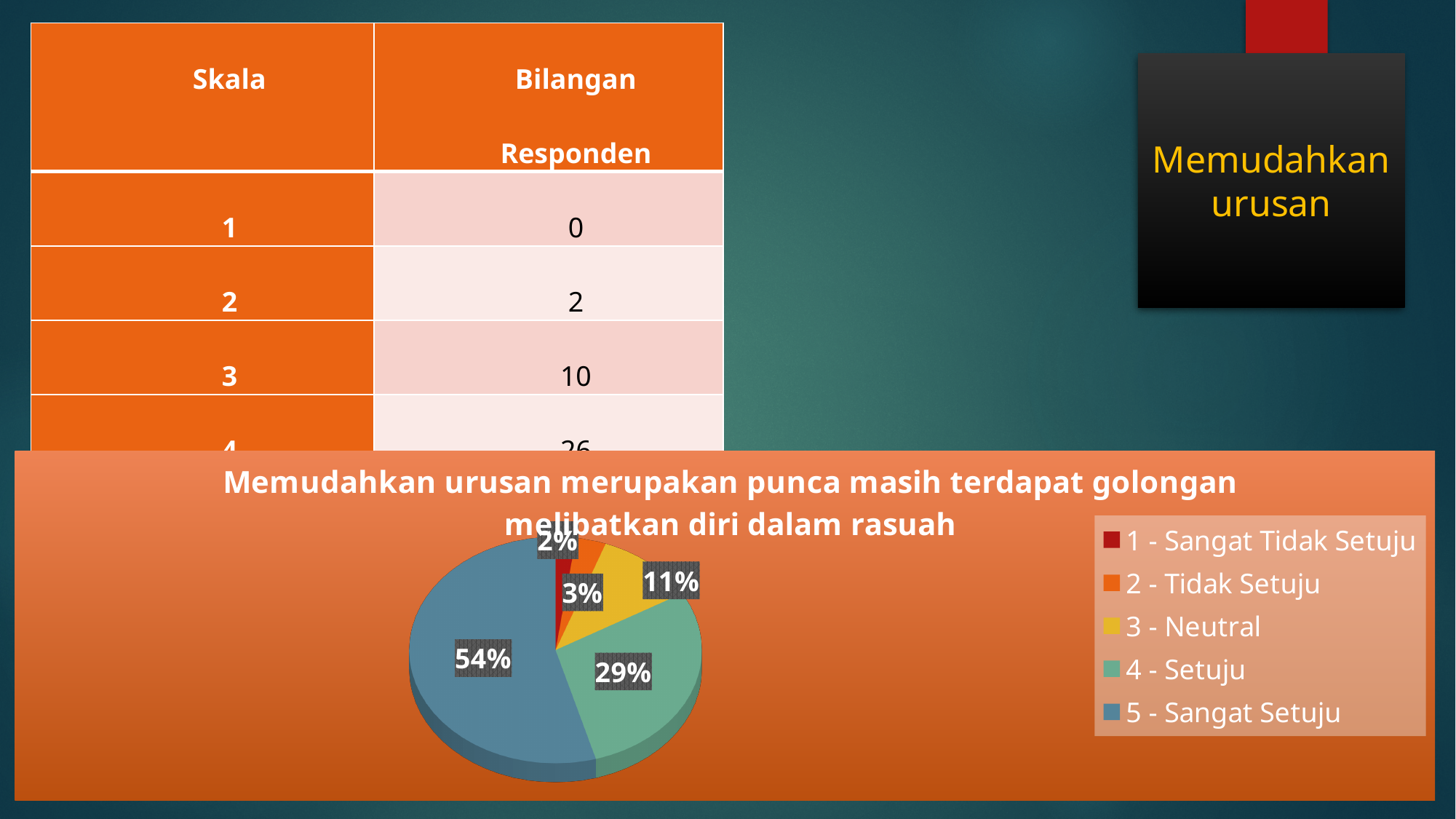
How many slices does the pie chart have? 5 Is the share for 5 - Sangat Setuju greater or less than 50%? greater How many entries does the legend of the pie chart list? 5 What kind of chart is shown on the slide? pie chart What is the smallest percentage label shown on the pie chart? 2% What is the difference in percentage points between the 5 - Sangat Setuju slice and the 4 - Setuju slice? 25% Which category has the largest share of the pie? 5 - Sangat Setuju Which slice is larger, 4 - Setuju or 3 - Neutral? 4 - Setuju What colour is the 5 - Sangat Setuju slice in the pie chart? blue What percentage of the pie is labelled for 5 - Sangat Setuju? 54% What percentage of the pie is labelled for 4 - Setuju? 29% What percentage of the pie is labelled for 3 - Neutral? 11%